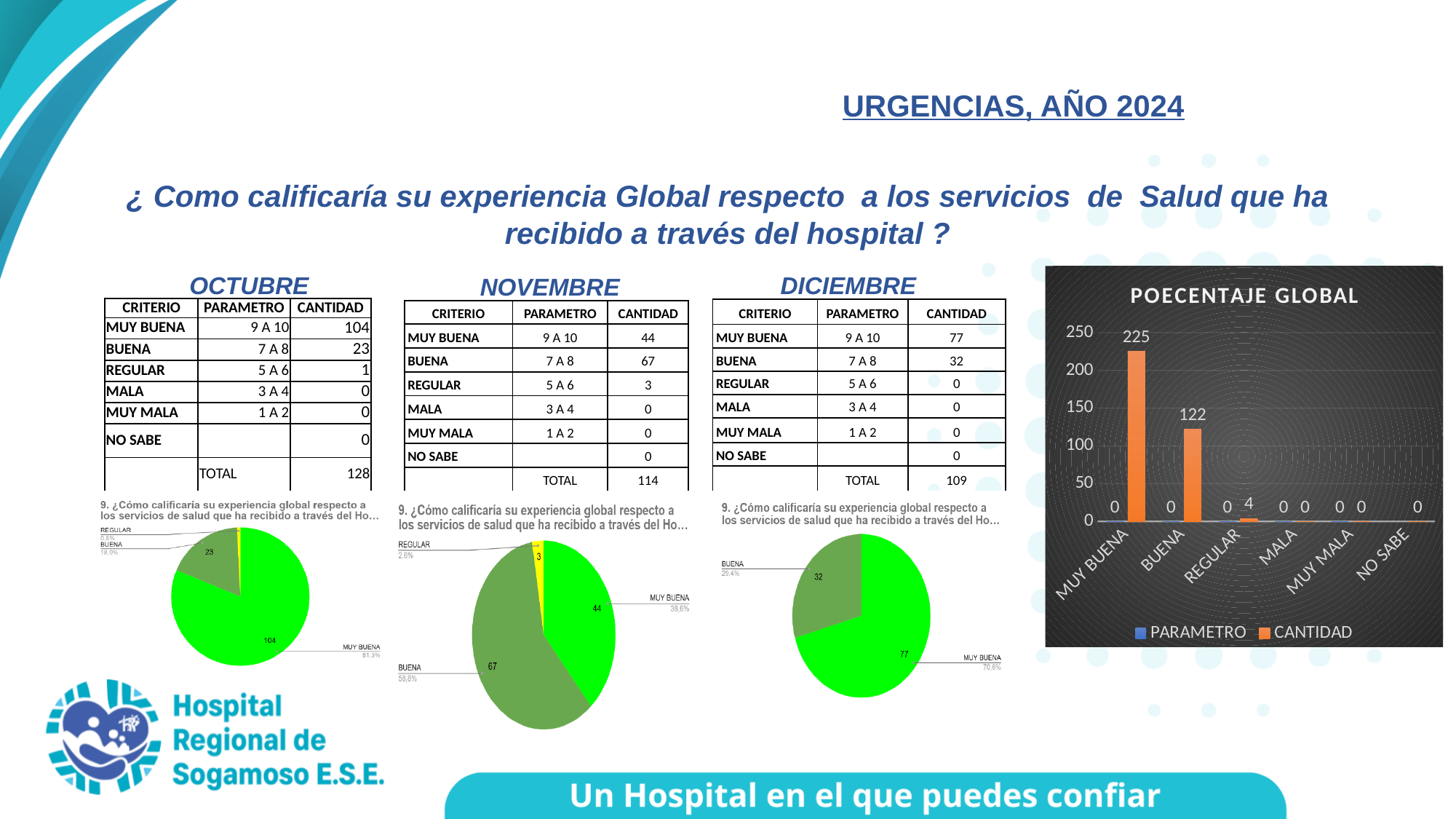
How many series does the legend of the POECENTAJE GLOBAL chart list? 2 In the POECENTAJE GLOBAL bar chart, what is the CANTIDAD value for MUY BUENA? 225 In the POECENTAJE GLOBAL bar chart, is the CANTIDAD value for BUENA greater or less than 100? greater In the OCTUBRE pie chart, what value is shown for MUY BUENA? 104 What kind of chart is the POECENTAJE GLOBAL chart on the right of the slide? Bar chart In the POECENTAJE GLOBAL bar chart, which category has the highest CANTIDAD value? MUY BUENA In the NOVEMBRE pie chart, which slice is larger, BUENA or MUY BUENA? BUENA In the NOVEMBRE pie chart, what share of the pie does BUENA represent? 58,8% How many categories are shown on the x axis of the POECENTAJE GLOBAL bar chart? 6 In the POECENTAJE GLOBAL bar chart, what is the difference between the CANTIDAD values for MUY BUENA and BUENA? 103 In the POECENTAJE GLOBAL bar chart, what is the CANTIDAD value for BUENA? 122 In the DICIEMBRE pie chart, what share of the pie does MUY BUENA represent? 70,6%